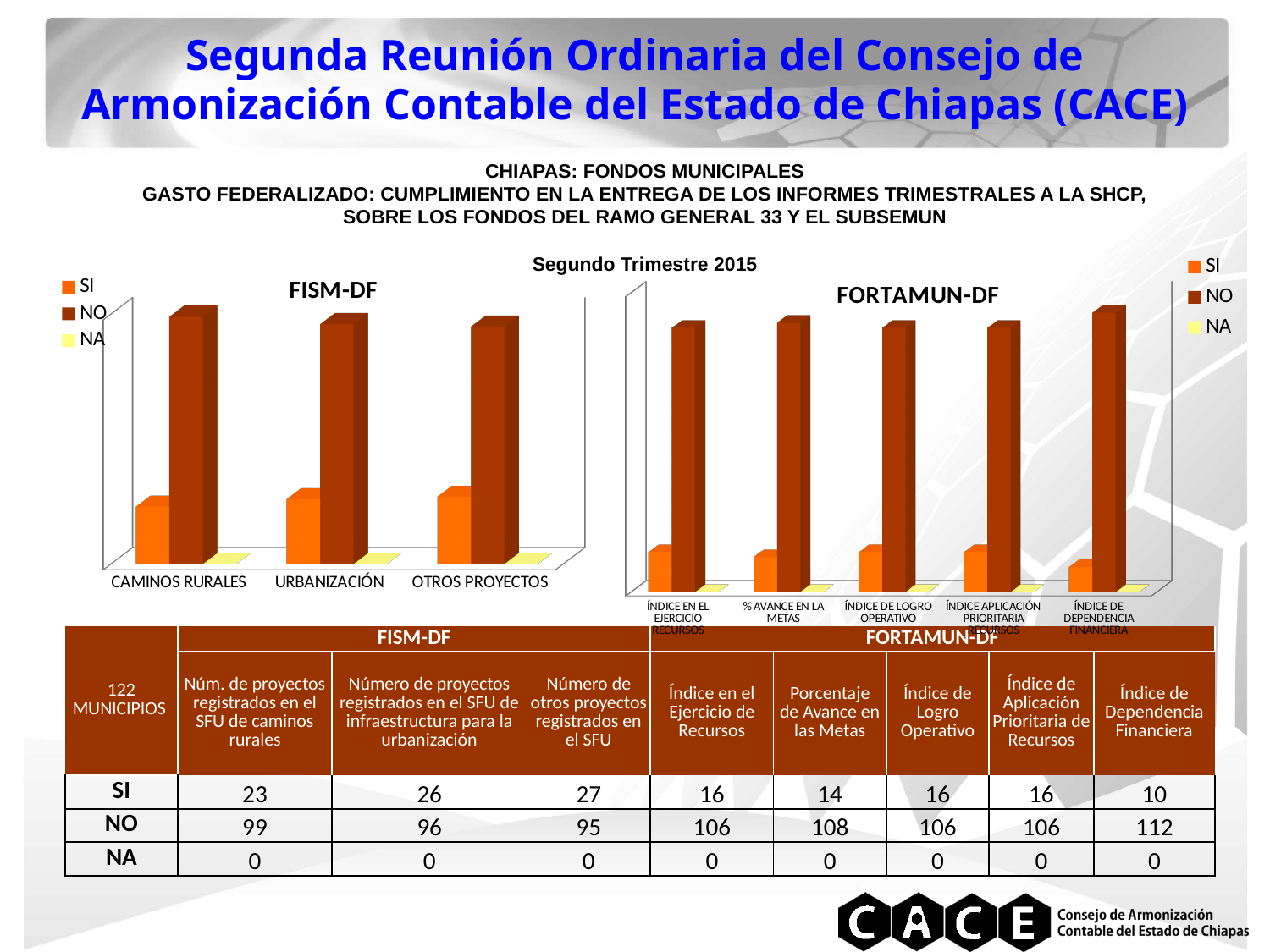
In the FORTAMUN-DF chart, which category has the lowest SI value? ÍNDICE DE DEPENDENCIA FINANCIERA In the FISM-DF chart, what is the difference between the NO and SI values for CAMINOS RURALES? 76 In the FORTAMUN-DF chart, what is the NA value for ÍNDICE DE LOGRO OPERATIVO? 0 How many categories are shown on the x axis of the FISM-DF chart? 3 How many series does the legend of the FISM-DF chart list? 3 What kind of chart is the FISM-DF chart? bar chart In the FORTAMUN-DF chart, what is the NO value for ÍNDICE DE DEPENDENCIA FINANCIERA? 112 How many categories are shown on the x axis of the FORTAMUN-DF chart? 5 In the FISM-DF chart, what is the SI value for CAMINOS RURALES? 23 What is the title of the chart on the right side of the slide? FORTAMUN-DF In the FISM-DF chart, what is the NO value for OTROS PROYECTOS? 95 In the FISM-DF chart, which series is larger for URBANIZACIÓN, SI or NO? NO